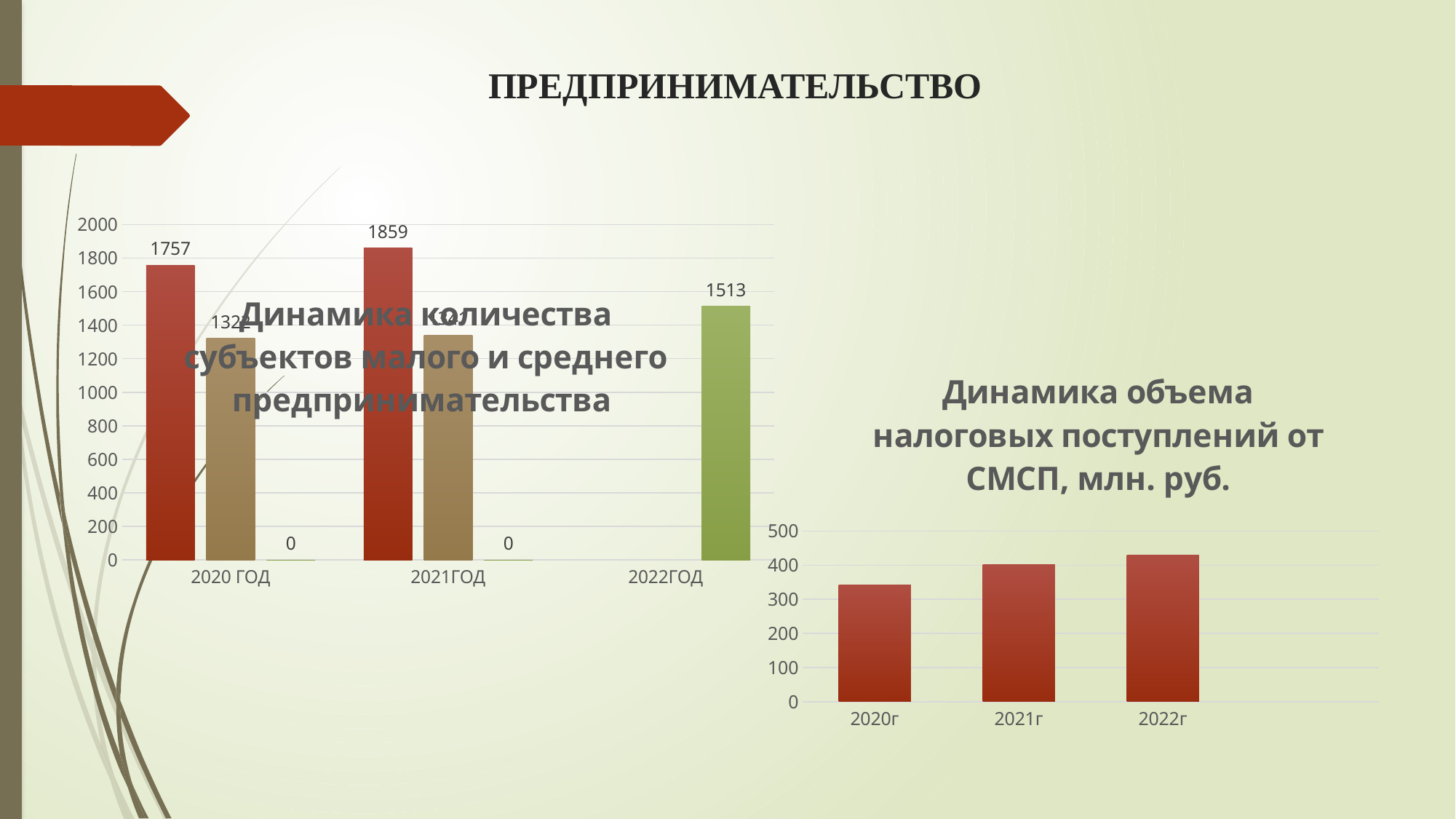
In the right chart, is the value for 2020г greater or less than 400? less In the left chart (Динамика количества субъектов малого и среднего предпринимательства), what value is labelled on the red bar for 2020 ГОД? 1757 What kind of chart is the right chart (Динамика объема налоговых поступлений от СМСП)? Bar chart In the right chart, do the values rise or fall from 2020г to 2022г? Rise In the left chart, what value is labelled on the red bar for 2021ГОД? 1859 In the left chart, what value is labelled on the green bar for 2022ГОД? 1513 In the left chart, what value is labelled on the green bar for 2020 ГОД? 0 In the left chart, what is the difference between the red bar values for 2021ГОД and 2020 ГОД? 102 In the right chart, is the value for 2022г greater or less than 400? greater In the left chart, which year has the highest labelled bar? 2021ГОД How many years are shown on the x axis of the right chart? 3 In the left chart, which is larger: the red bar for 2020 ГОД or the green bar for 2022ГОД? The red bar for 2020 ГОД